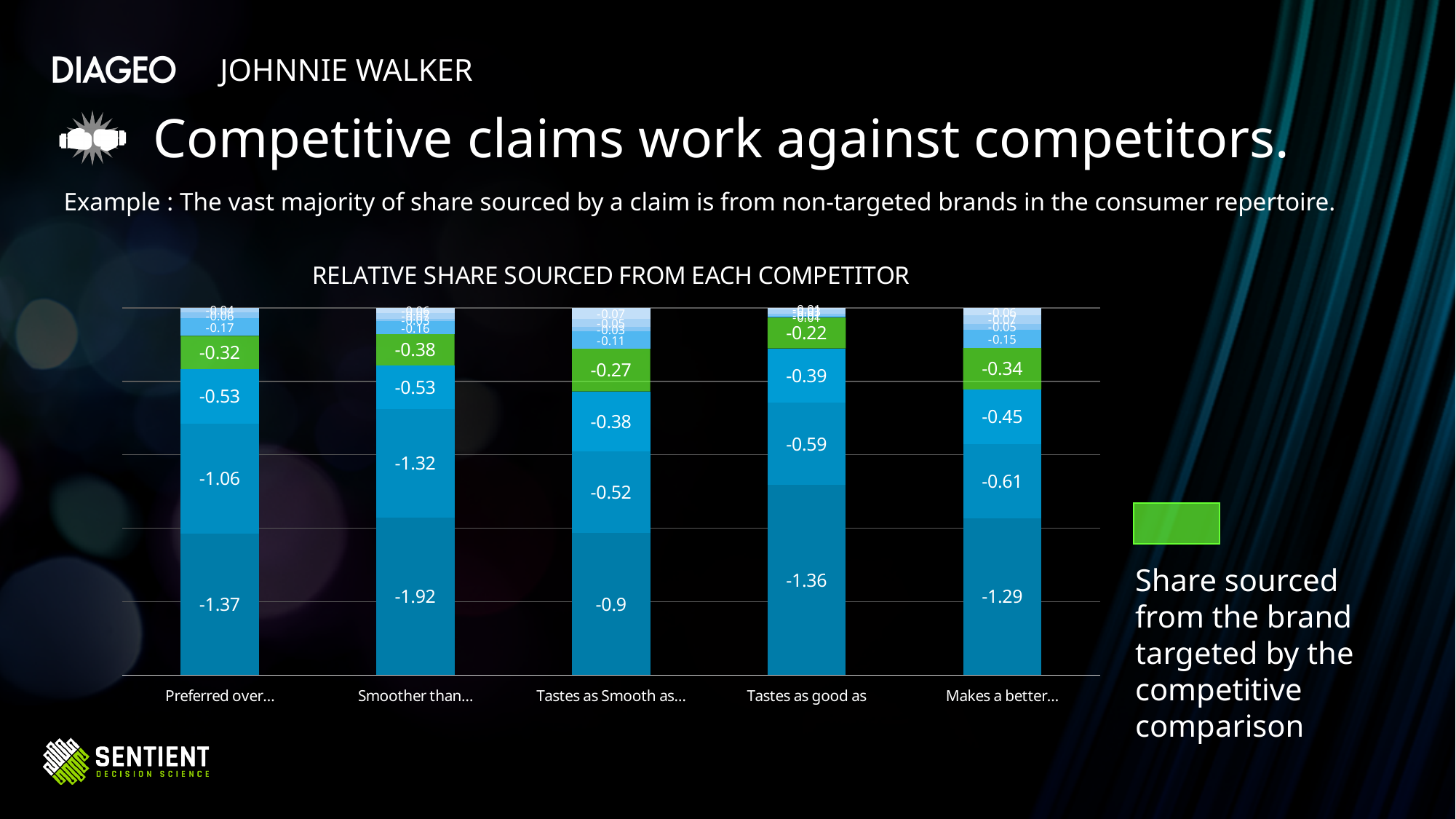
Which has the bottom segment with the larger magnitude: "Preferred over..." or "Tastes as Smooth as..."? Preferred over... What kind of chart is shown under the title "RELATIVE SHARE SOURCED FROM EACH COMPETITOR"? Stacked bar chart Which claim has the green segment with the smallest magnitude? Tastes as good as What is the value of the green segment for "Preferred over..."? -0.32 Which claim has the bottom segment with the largest magnitude? Smoother than... What is the value of the bottom (largest) segment for "Smoother than..."? -1.92 What is the title of the chart? RELATIVE SHARE SOURCED FROM EACH COMPETITOR What is the value of the second segment from the bottom for "Tastes as good as"? -0.59 What is the difference in magnitude between the green segments for "Smoother than..." (-0.38) and "Tastes as Smooth as..." (-0.27)? 0.11 How many claim categories are shown along the x axis of the chart? 5 What is the value of the green segment for "Makes a better..."? -0.34 According to the legend, what does the green segment represent? Share sourced from the brand targeted by the competitive comparison